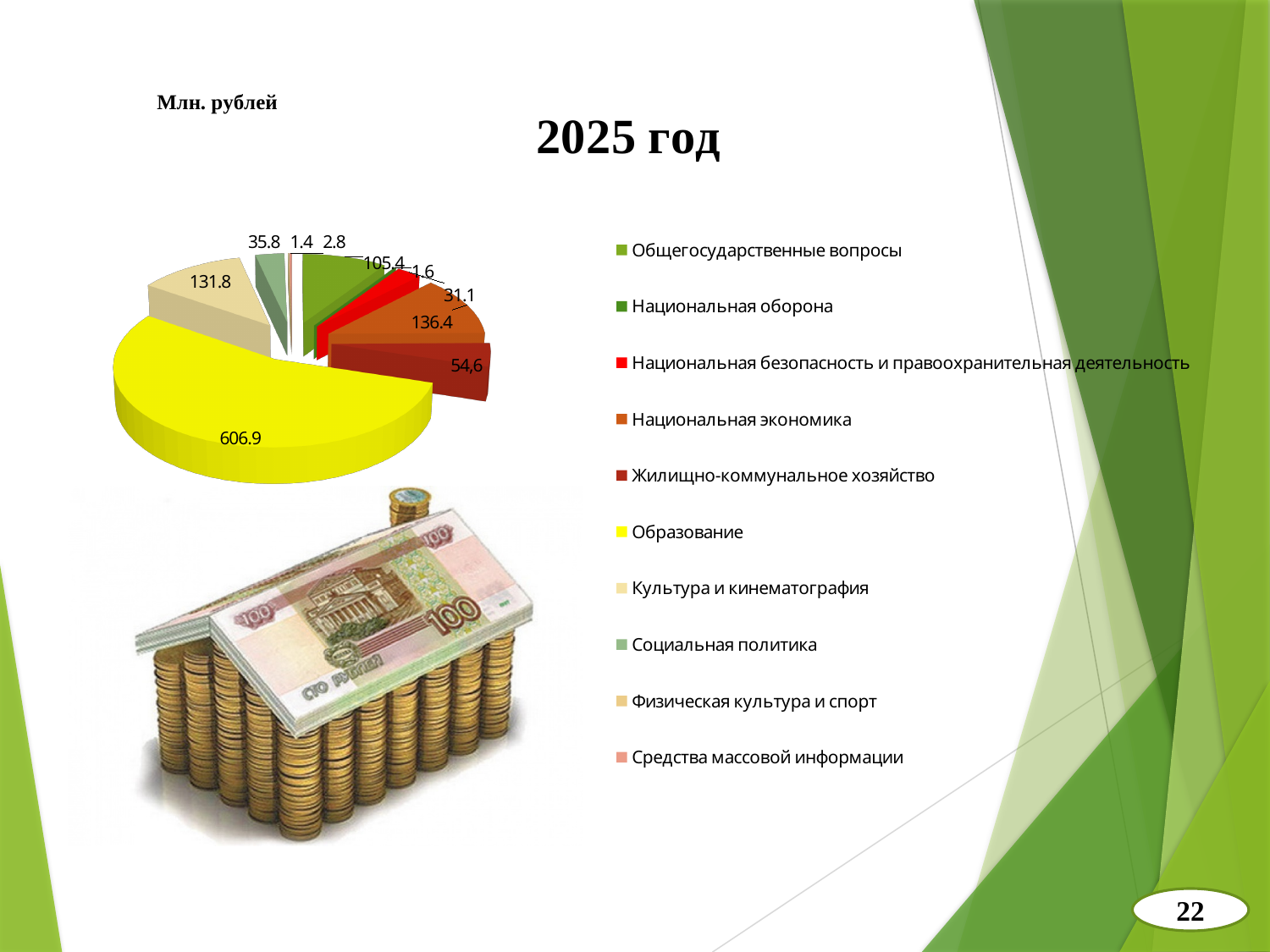
What kind of chart is shown on the slide? Pie chart What is the value for Культура и кинематография on the pie chart? 131.8 Which category has the smallest value on the pie chart? Физическая культура и спорт Which category has the largest slice of the pie chart? Образование What is the value for Образование on the pie chart? 606.9 What is the value for Национальная экономика on the pie chart? 136.4 What is the difference between the values for Национальная экономика and Культура и кинематография? 4.6 Which is larger: the value for Национальная экономика or the value for Культура и кинематография? Национальная экономика What is the value for Общегосударственные вопросы on the pie chart? 105.4 What is the value for Жилищно-коммунальное хозяйство on the pie chart? 54,6 What unit is stated for the values on the chart? Млн. рублей How many categories does the pie chart show? 10